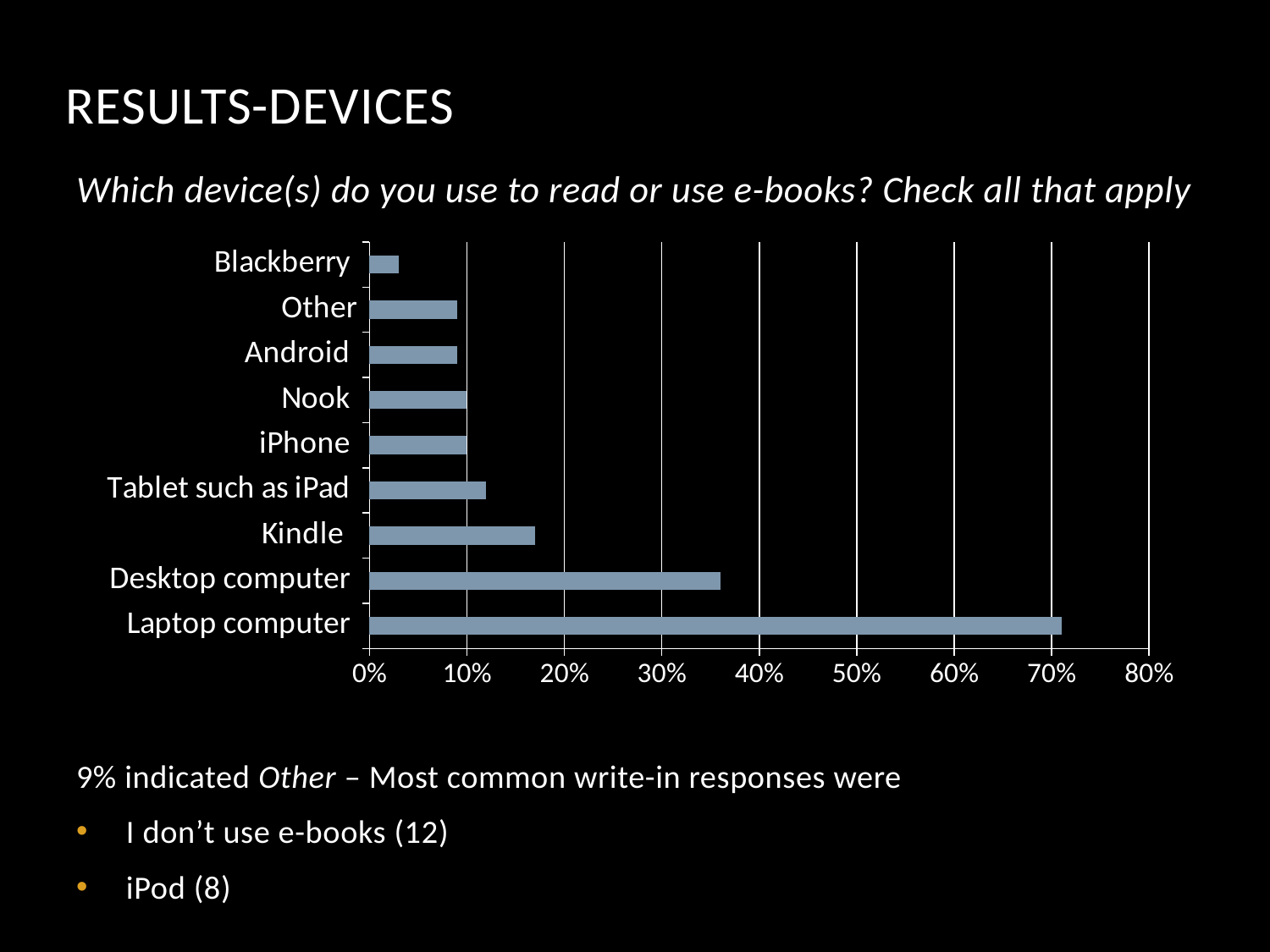
Which device has the lowest percentage in the chart? Blackberry Is the value for Blackberry greater or less than 10%? less Is the value for Desktop computer greater or less than 30%? greater Is the value for Kindle greater or less than 20%? less Which has a larger value, Desktop computer or Kindle? Desktop computer What kind of chart is shown on the slide? bar chart Which has a larger value, Laptop computer or Desktop computer? Laptop computer How many device categories are plotted in the chart? 9 Which device has the highest percentage in the chart? Laptop computer According to the slide text, what percentage of respondents indicated Other? 9%